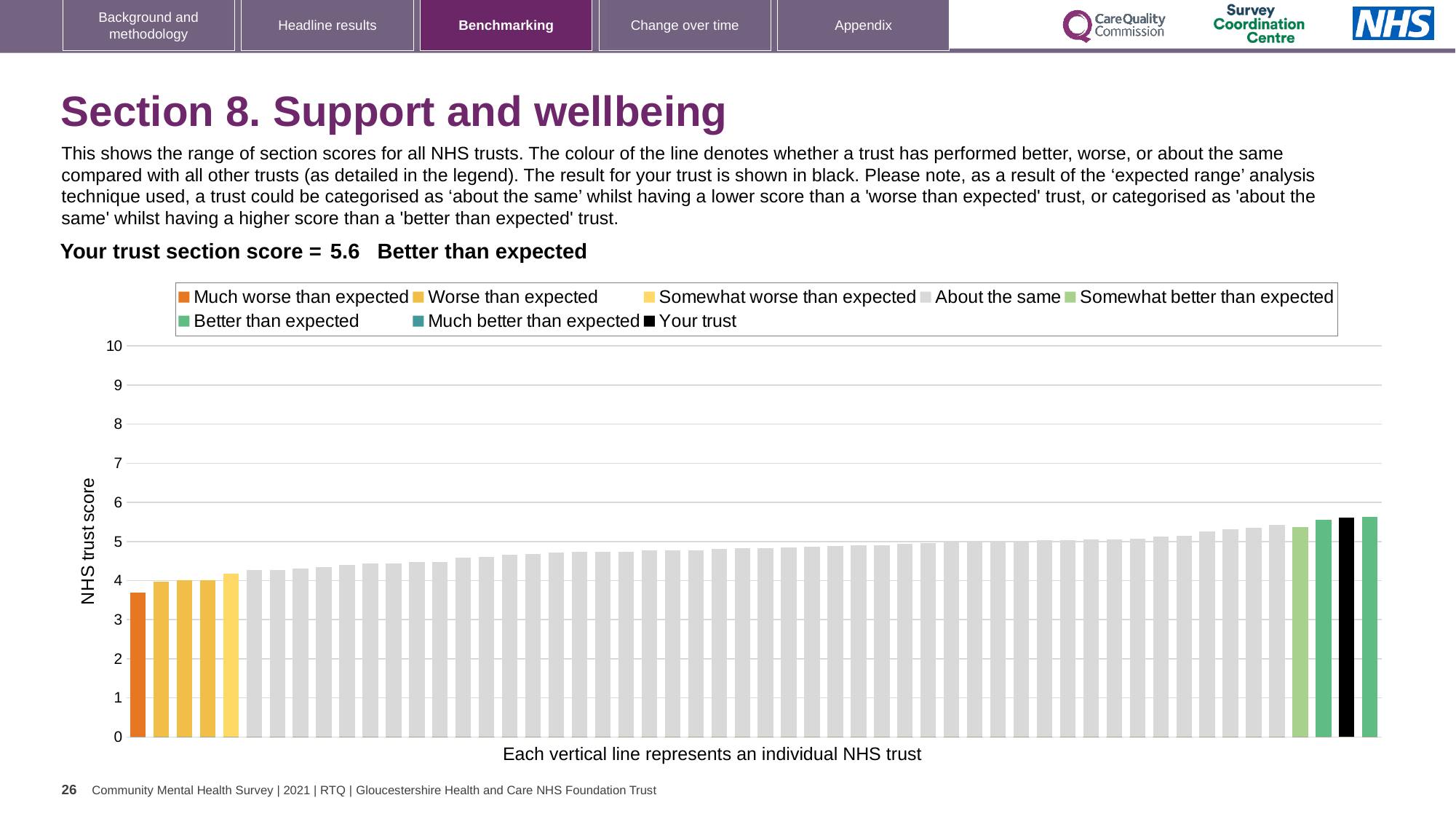
Is the value of the lowest bar (the orange bar on the far left) greater or less than 4? less According to the legend, what colour represents 'Your trust'? black What kind of chart is shown on the slide? bar chart Is the value of the highest bar on the far right greater or less than 5? greater How is your trust's section score categorised on the slide? Better than expected Is the value for your trust (the black bar) greater or less than 6? less What is the label on the vertical axis of the chart? NHS trust score What is the section score for your trust shown on the slide? 5.6 How many entries does the chart legend list? 8 What is the highest value shown on the vertical axis? 10 Do the bar values rise or fall from left to right along the x axis? rise